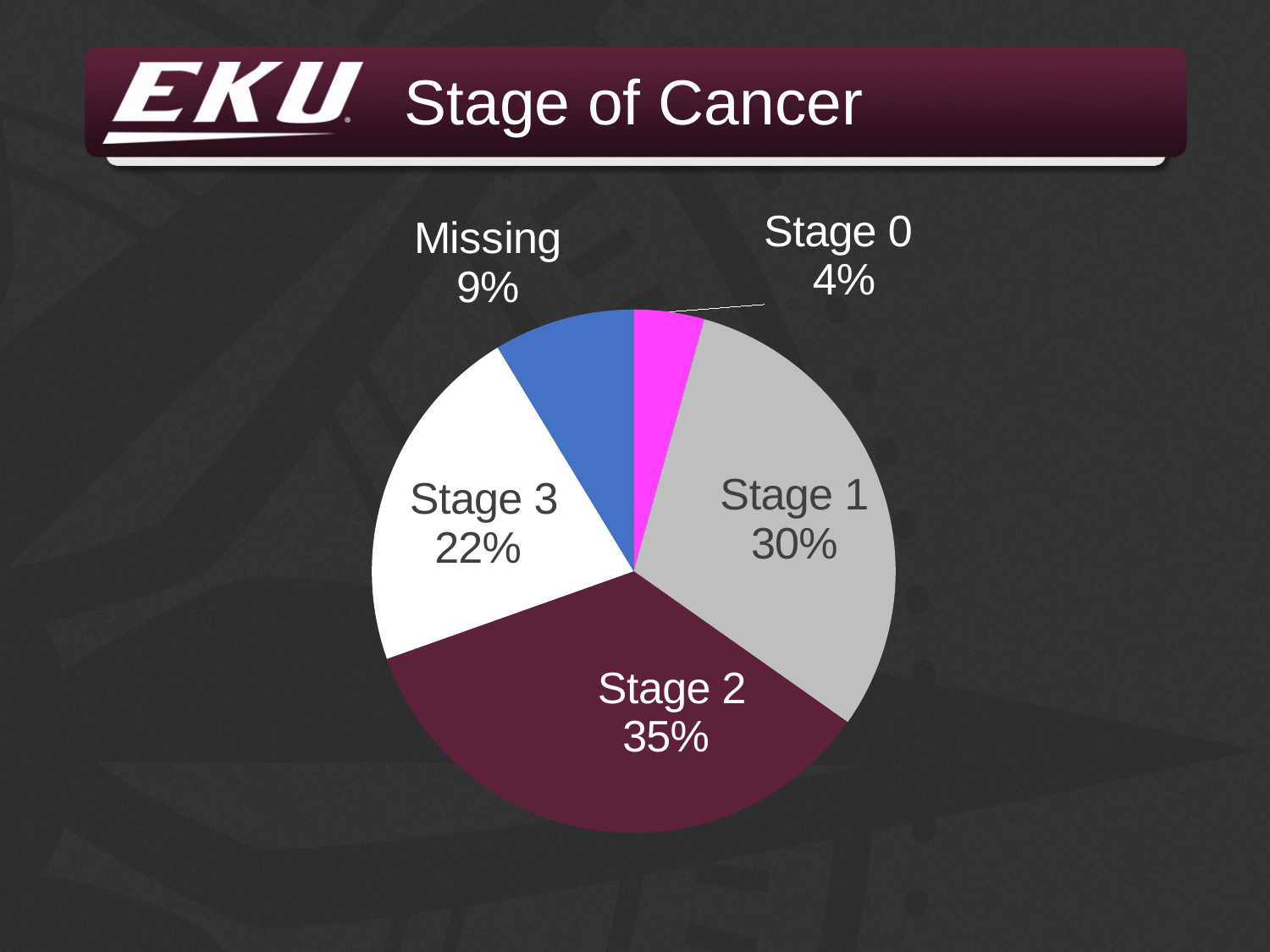
What is the title of the chart? Stage of Cancer What percentage of cases are labelled Missing? 9% Which stage category has the largest share of the pie? Stage 2 What is the difference in percentage points between Stage 3 and Missing? 13 How many slices does the pie chart have? 5 What percentage of cases are Stage 0? 4% What kind of chart is shown on the slide? pie chart What percentage of cases are Stage 2? 35% What percentage of cases are Stage 3? 22% What is the difference in percentage points between Stage 2 and Stage 1? 5 Which is larger, the share for Stage 1 or the share for Stage 3? Stage 1 Which category has the smallest share of the pie? Stage 0